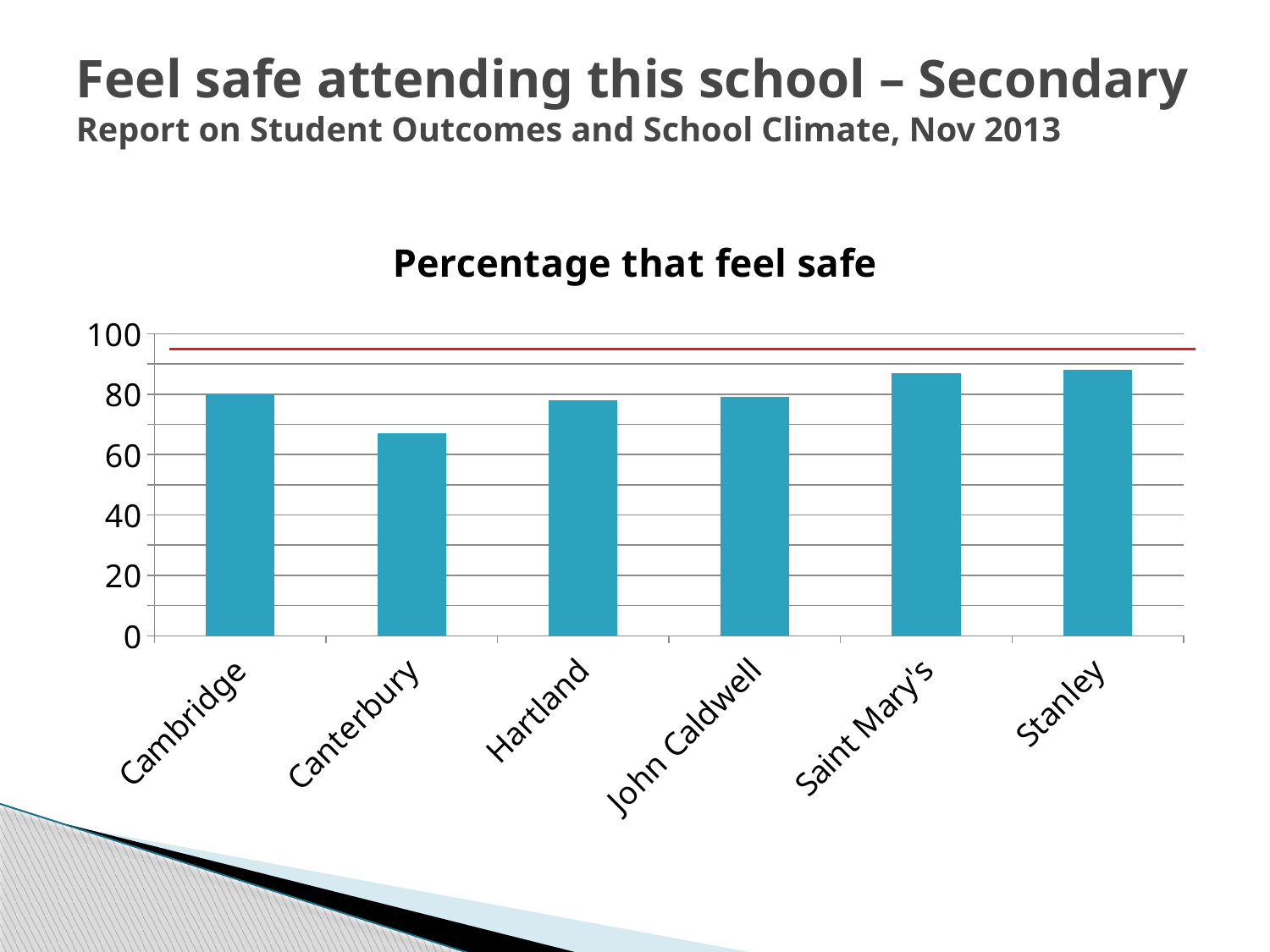
What is the title of the chart? Percentage that feel safe Is the value for Stanley greater or less than 100? less Which school has the lowest percentage that feel safe? Canterbury Is the value for Canterbury greater or less than 60? greater Is the value for Saint Mary's greater or less than 80? greater Which has a higher percentage that feel safe, Hartland or Saint Mary's? Saint Mary's Which has a higher percentage that feel safe, Cambridge or Canterbury? Cambridge What kind of chart is shown on the slide? bar chart How many schools are shown on the x axis of the chart? 6 What colour are the bars in the chart? blue